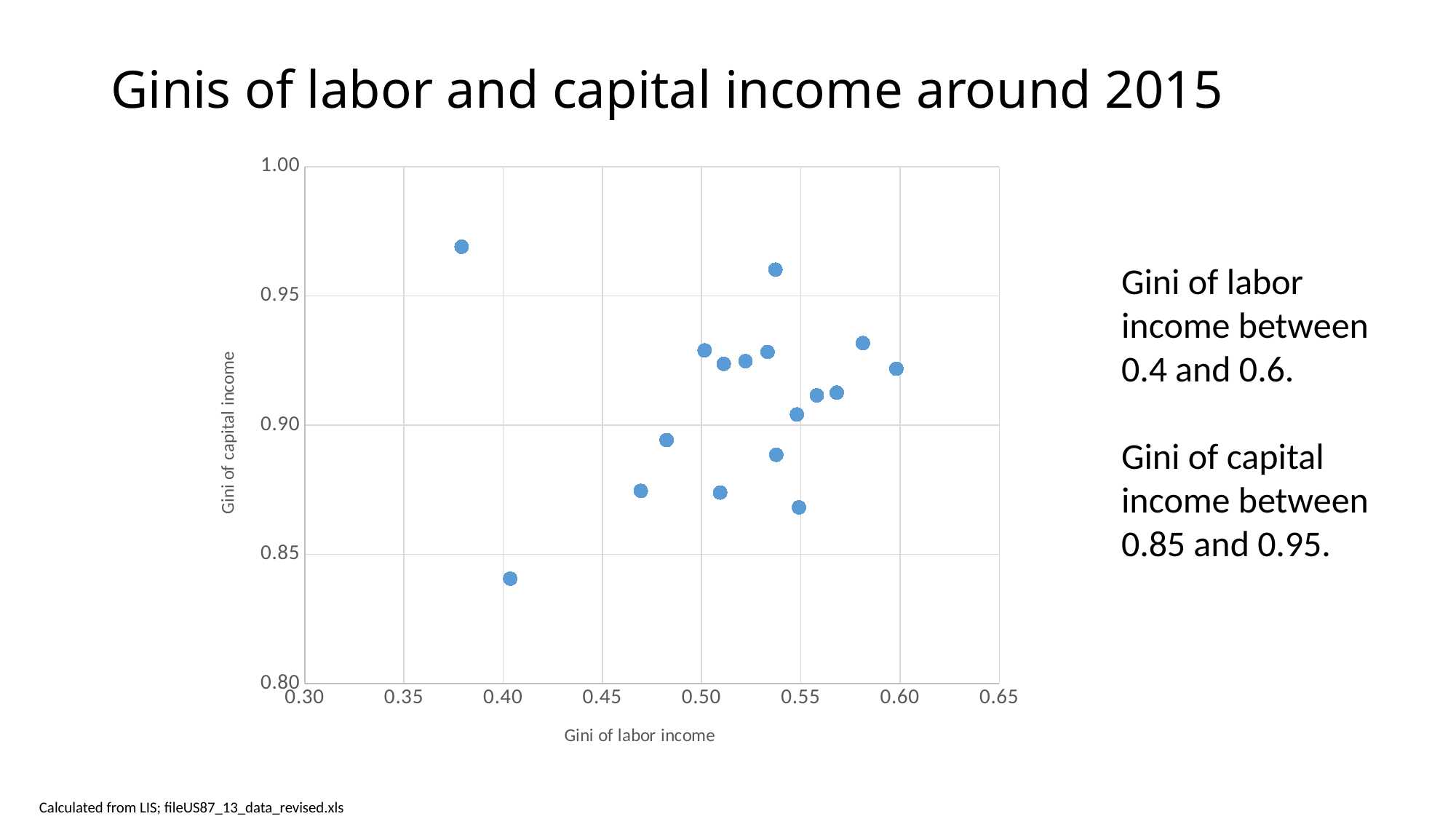
Is the highest Gini of capital income plotted on the chart greater or less than 0.95? greater Is the lowest Gini of capital income plotted on the chart greater or less than 0.85? less Is the Gini of labor income of the point with the lowest Gini of capital income greater or less than 0.45? less What kind of chart is shown on the slide? scatter plot What is the maximum value shown on the vertical axis of the chart? 1.00 What is the title of the chart? Ginis of labor and capital income around 2015 How many data points are plotted on the chart? 17 What is the label of the vertical axis of the chart? Gini of capital income